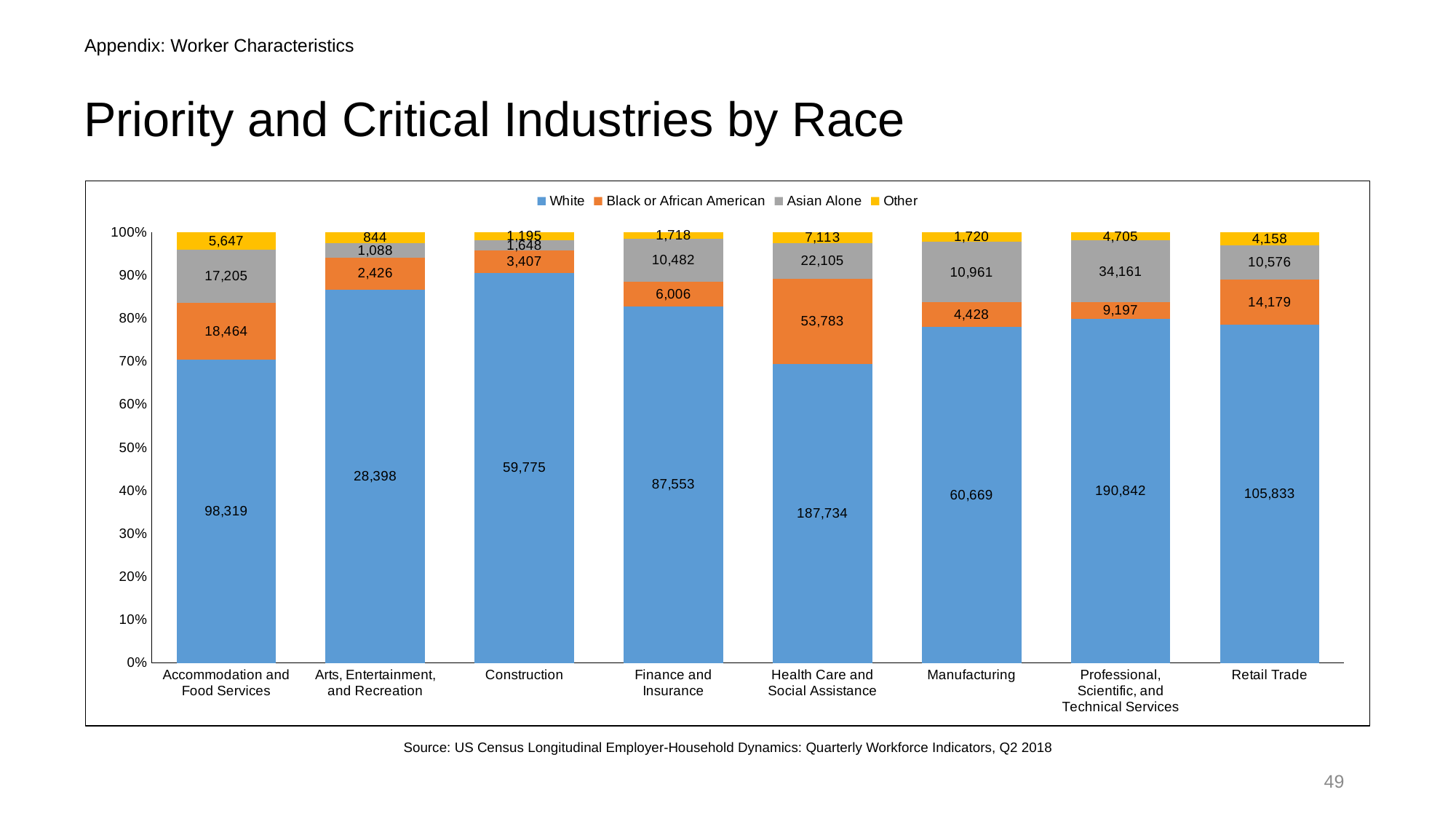
How many industries are shown on the x axis? 8 Which industry has the lowest value for White? Arts, Entertainment, and Recreation Is the White share of the Construction bar greater or less than 80%? greater What is the value for White in Health Care and Social Assistance? 187,734 Which industry has the highest value for White? Professional, Scientific, and Technical Services What is the total of the four values in the Accommodation and Food Services bar? 139,635 What is the value for Asian Alone in Professional, Scientific, and Technical Services? 34,161 How many series does the legend list? 4 What is the difference between the Black or African American values for Health Care and Social Assistance and Retail Trade? 39,604 What is the value for Other in Retail Trade? 4,158 What is the value for Black or African American in Accommodation and Food Services? 18,464 Which is larger, the Asian Alone value for Professional, Scientific, and Technical Services or for Health Care and Social Assistance? Professional, Scientific, and Technical Services